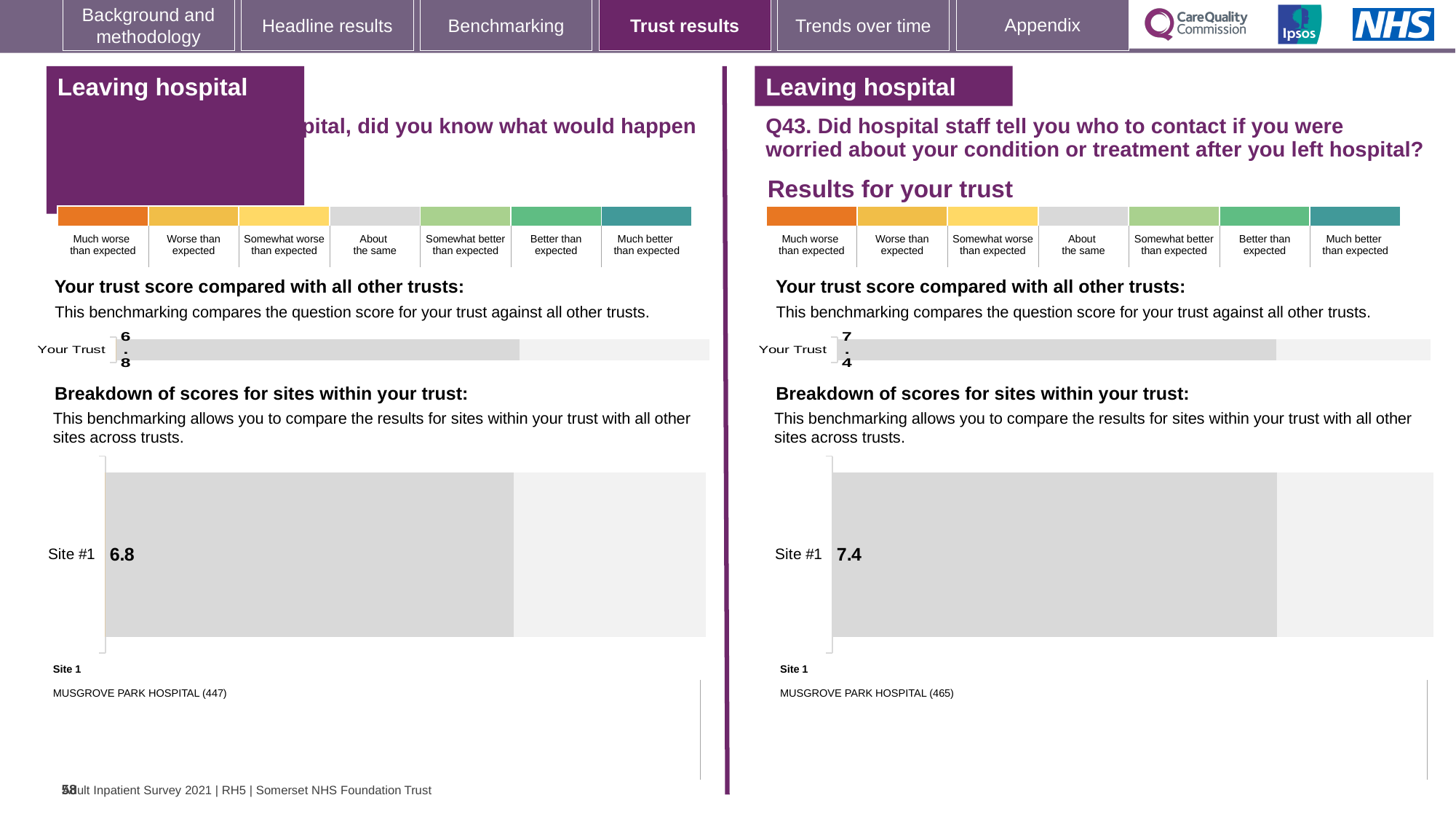
On the left half of the slide, what is the score shown for Site #1 in the 'Breakdown of scores for sites within your trust' chart? 6.8 What is the difference between the Site #1 score on the right half of the slide (Q43) and the Site #1 score on the left half? 0.6 Which is larger: the Your Trust score on the left half of the slide or the Your Trust score on the right half (Q43)? Right half (Q43) On the right half of the slide (Q43), which site name is listed under Site 1 below the breakdown chart? MUSGROVE PARK HOSPITAL (465) What type of chart is used to show the Site #1 score on the right half of the slide (Q43)? Bar chart On the left half of the slide, which site name is listed under Site 1 below the breakdown chart? MUSGROVE PARK HOSPITAL (447) On the right half of the slide (Q43), what is the score shown for Your Trust in the 'Your trust score compared with all other trusts' chart? 7.4 On the left half of the slide, what is the score shown for Your Trust in the 'Your trust score compared with all other trusts' chart? 6.8 How many sites are plotted in the 'Breakdown of scores for sites within your trust' chart on the right half of the slide (Q43)? 1 On the right half of the slide (Q43), what is the score shown for Site #1 in the 'Breakdown of scores for sites within your trust' chart? 7.4